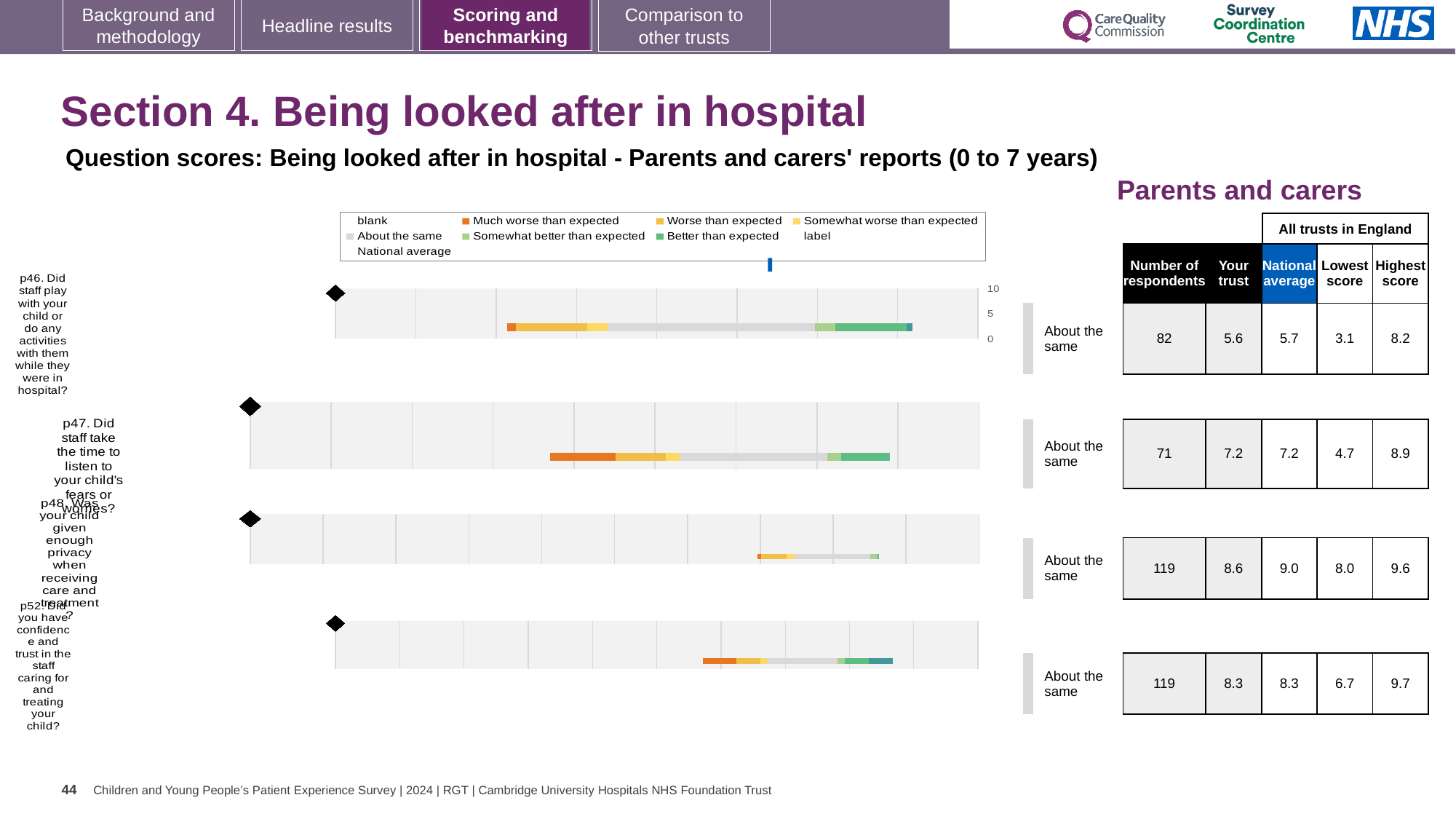
What is the 'Your trust' score for p46 (Did staff play with your child or do any activities with them while they were in hospital?)? 5.6 How many respondents answered p47 (Did staff take the time to listen to your child's fears or worries?)? 71 What is the difference between the national average and the 'Your trust' score for p48? 0.4 For p46, which is larger: the 'Your trust' score or the national average? National average What is the national average score for p48 (Was your child given enough privacy when receiving care and treatment?)? 9.0 How many questions (categories) are plotted in the chart? 4 What kind of chart is used to show the question scores on this slide? bar chart What is the highest score among all trusts in England for p52 (Did you have confidence and trust in the staff caring for and treating your child?)? 9.7 What is the lowest score among all trusts in England for p47? 4.7 Which question has the highest 'Your trust' score? p48. Was your child given enough privacy when receiving care and treatment? What benchmark rating is shown for all four questions in the chart? About the same Which question has the lowest 'Your trust' score? p46. Did staff play with your child or do any activities with them while they were in hospital?